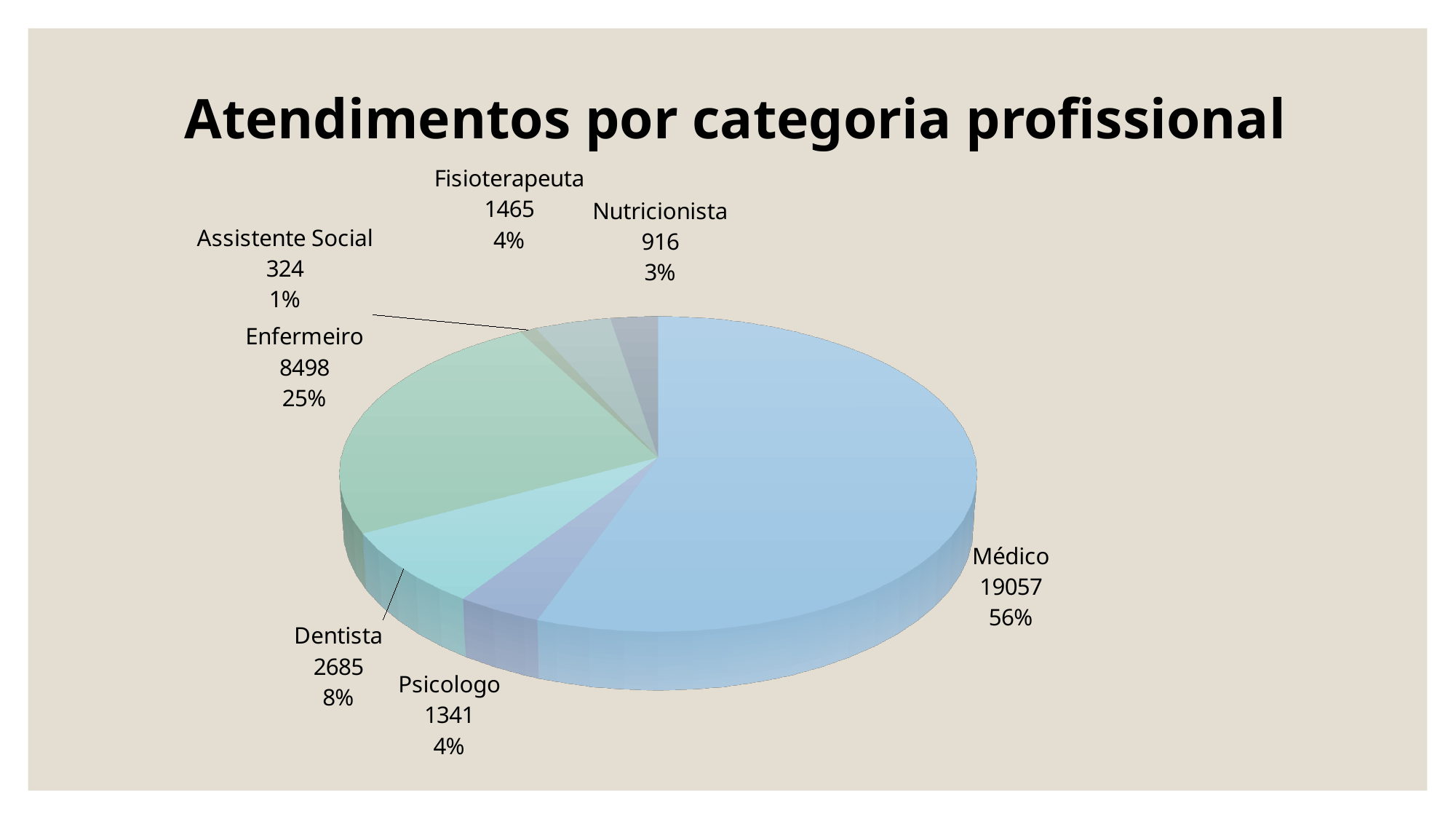
What share of the pie does Nutricionista represent? 3% Which category has the lowest value? Assistente Social What is the value for Médico? 19057 What is the title of the chart? Atendimentos por categoria profissional What is the value for Dentista? 2685 What share of the pie does Médico represent? 56% What is the difference between the values for Médico and Enfermeiro? 10559 Which is larger, the value for Fisioterapeuta or the value for Psicologo? Fisioterapeuta Which category has the highest value? Médico What kind of chart is shown on the slide? Pie chart How many categories does the pie chart show? 7 What is the value for Enfermeiro? 8498